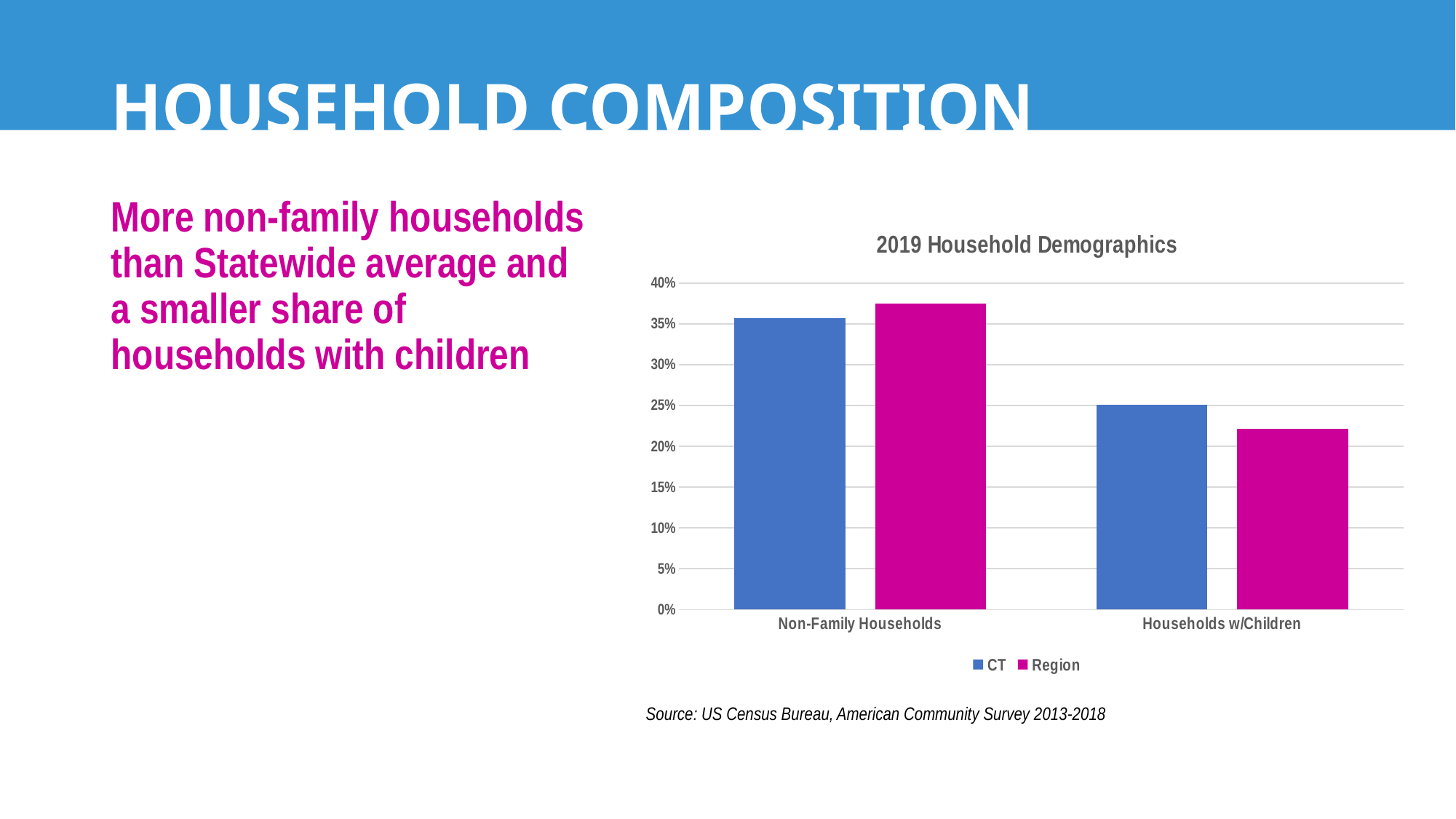
Is the CT value for Non-Family Households greater or less than 30%? greater Which bar is the tallest in the chart? Region, Non-Family Households What is the title of the chart? 2019 Household Demographics For Households w/Children, which is larger, CT or Region? CT Is the Region value for Non-Family Households greater or less than 35%? greater For Non-Family Households, which is larger, CT or Region? Region How many series does the chart's legend list? 2 What type of chart is shown on the slide? Bar chart Is the Region value for Households w/Children greater or less than 25%? less Which bar is the shortest in the chart? Region, Households w/Children How many categories are shown on the x axis of the chart? 2 Which series is shown in magenta in the chart? Region